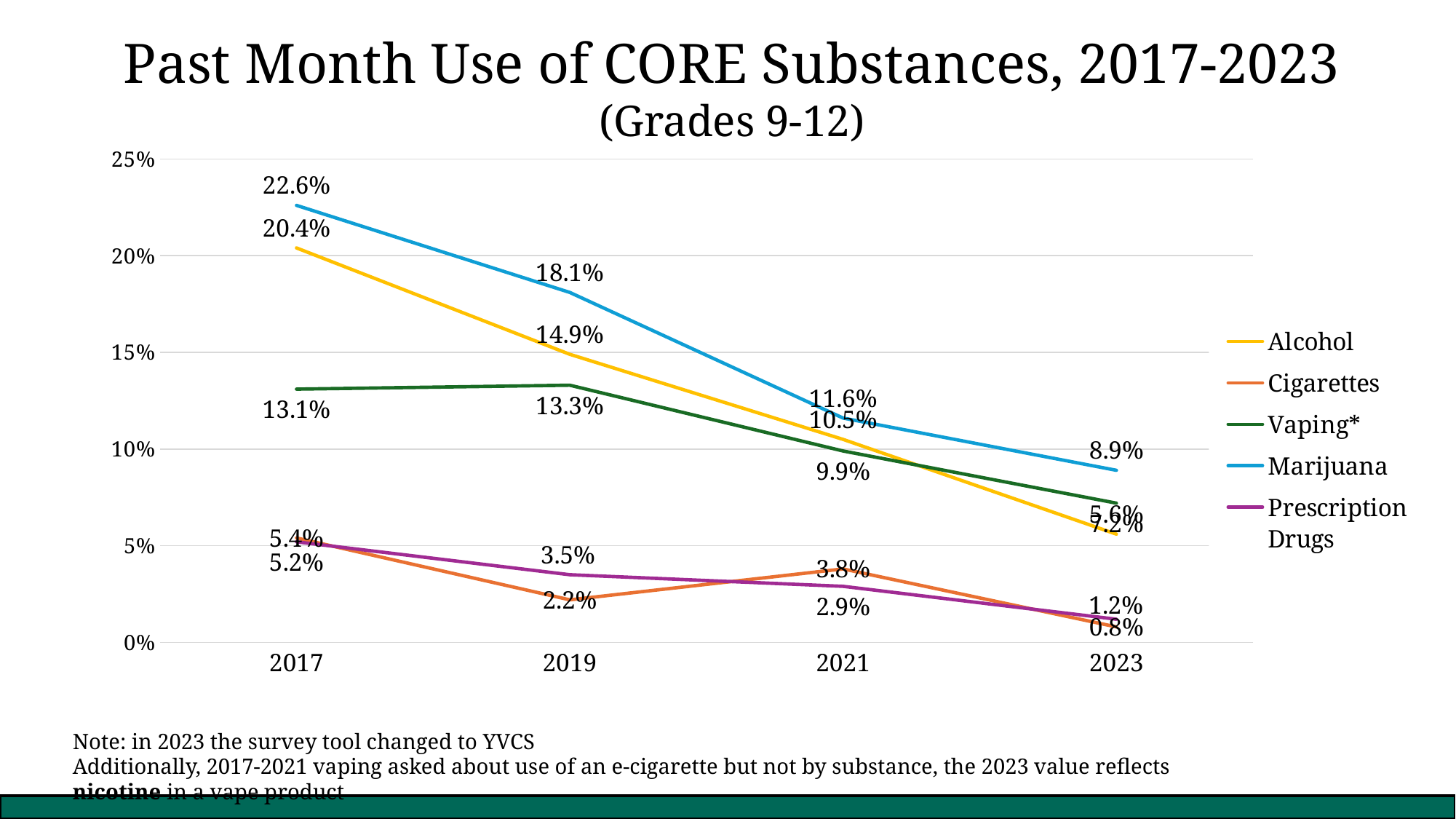
By how many percentage points did Marijuana use fall from 2017 to 2023? 13.7 percentage points In 2023, which was higher: Vaping* or Alcohol? Vaping* How many years are plotted along the x axis? 4 What was the past month use of Marijuana in 2017? 22.6% What was the Vaping* value in 2021? 9.9% What was the Cigarettes value in 2023? 0.8% What was the Prescription Drugs value in 2021? 2.9% Which substance had the highest past month use in 2017? Marijuana What kind of chart is shown on the slide? Line chart How many series does the legend list? 5 What was the past month use of Alcohol in 2019? 14.9% Does the Alcohol line rise or fall from 2017 to 2023? Fall